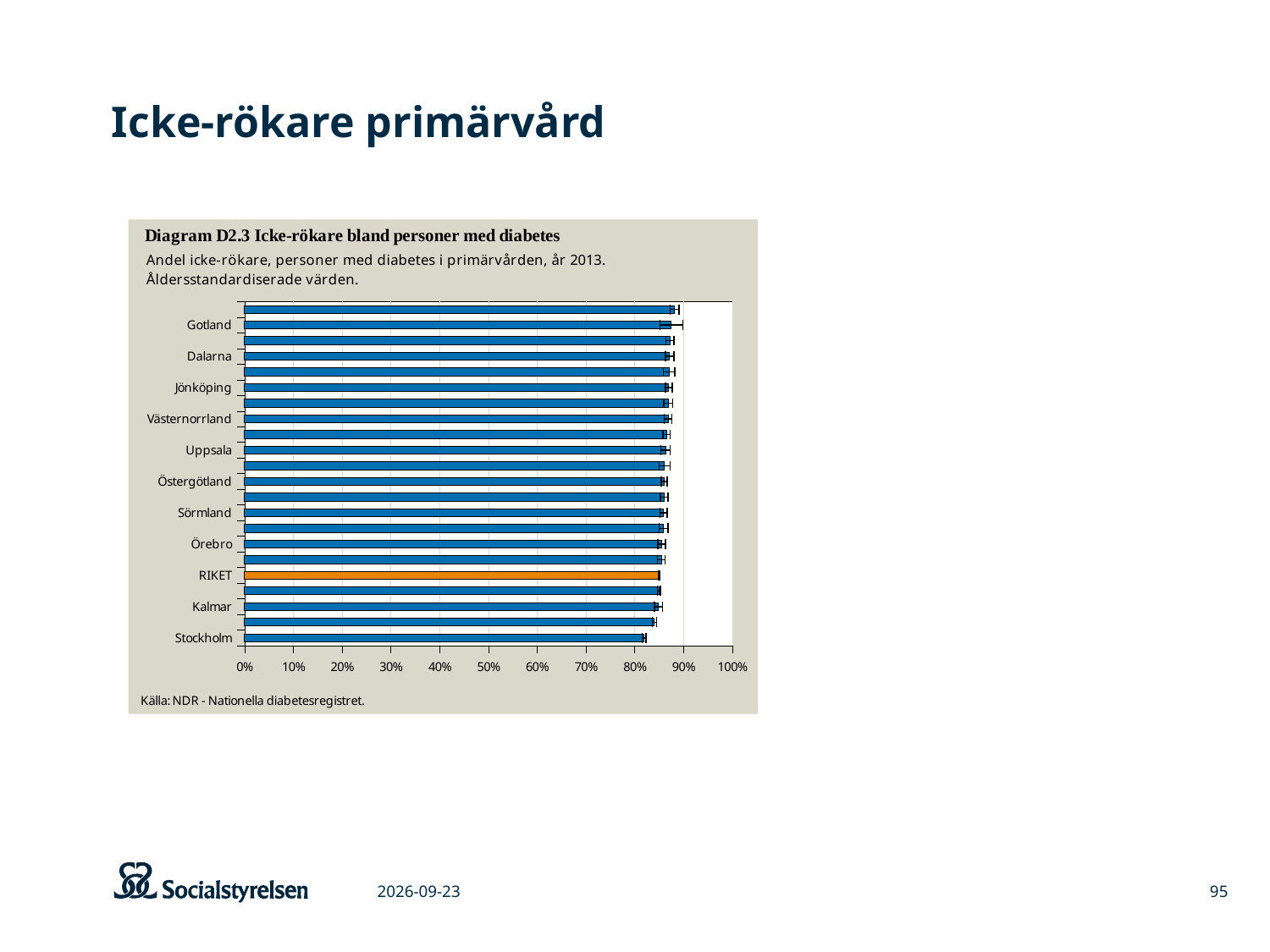
Is the value for RIKET greater or less than 90%? less Which has the larger value, Dalarna or Kalmar? Dalarna What is the title of the diagram? Diagram D2.3 Icke-rökare bland personer med diabetes Is the value for Gotland greater or less than 80%? greater Which category has the lowest value in the chart? Stockholm Is the value for Kalmar greater or less than 80%? greater What kind of chart is shown on the slide? bar chart Which category is drawn with an orange bar instead of a blue one? RIKET Which has the larger value, Gotland or Stockholm? Gotland Do the bar values increase or decrease going from the top of the chart to the bottom? decrease